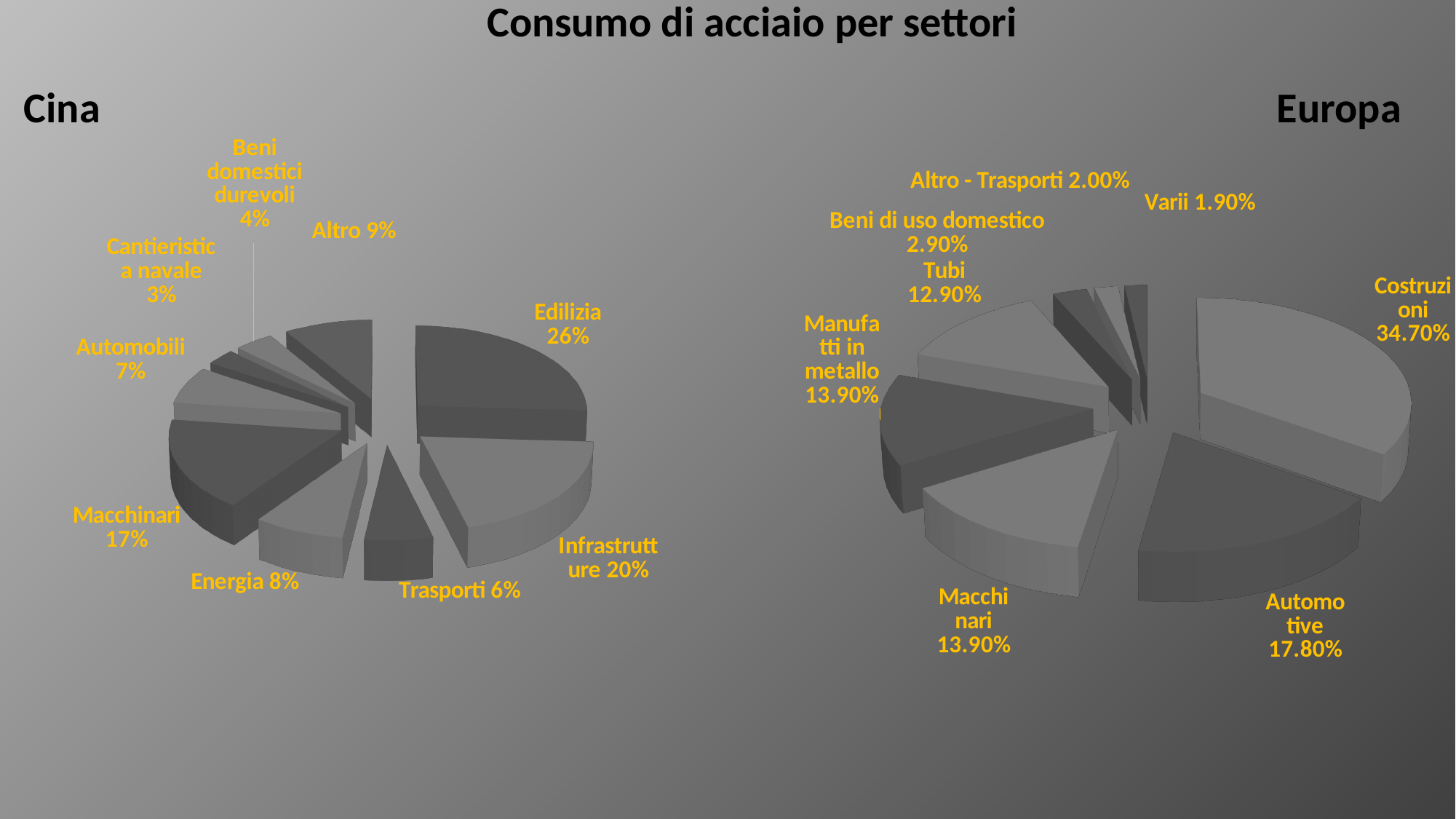
In the Cina chart, which is larger, Energia or Automobili? Energia In the Cina chart, which sector has the largest share? Edilizia In the Cina chart, what is the difference between the shares of Edilizia and Infrastrutture? 6% In the Europa chart, which sector has the smallest share? Varii In the Cina chart, what share does Edilizia have? 26% How many sectors are shown in the Europa chart? 8 In the Europa chart, which sector has the largest share? Costruzioni In the Cina chart, which sector has the smallest share? Cantieristica navale In the Europa chart, what is the difference between the shares of Costruzioni and Automotive? 16.90% In the Europa chart, what share does Costruzioni have? 34.70% What type of chart is used for the Europa data? Pie chart How many sectors are shown in the Cina chart? 9